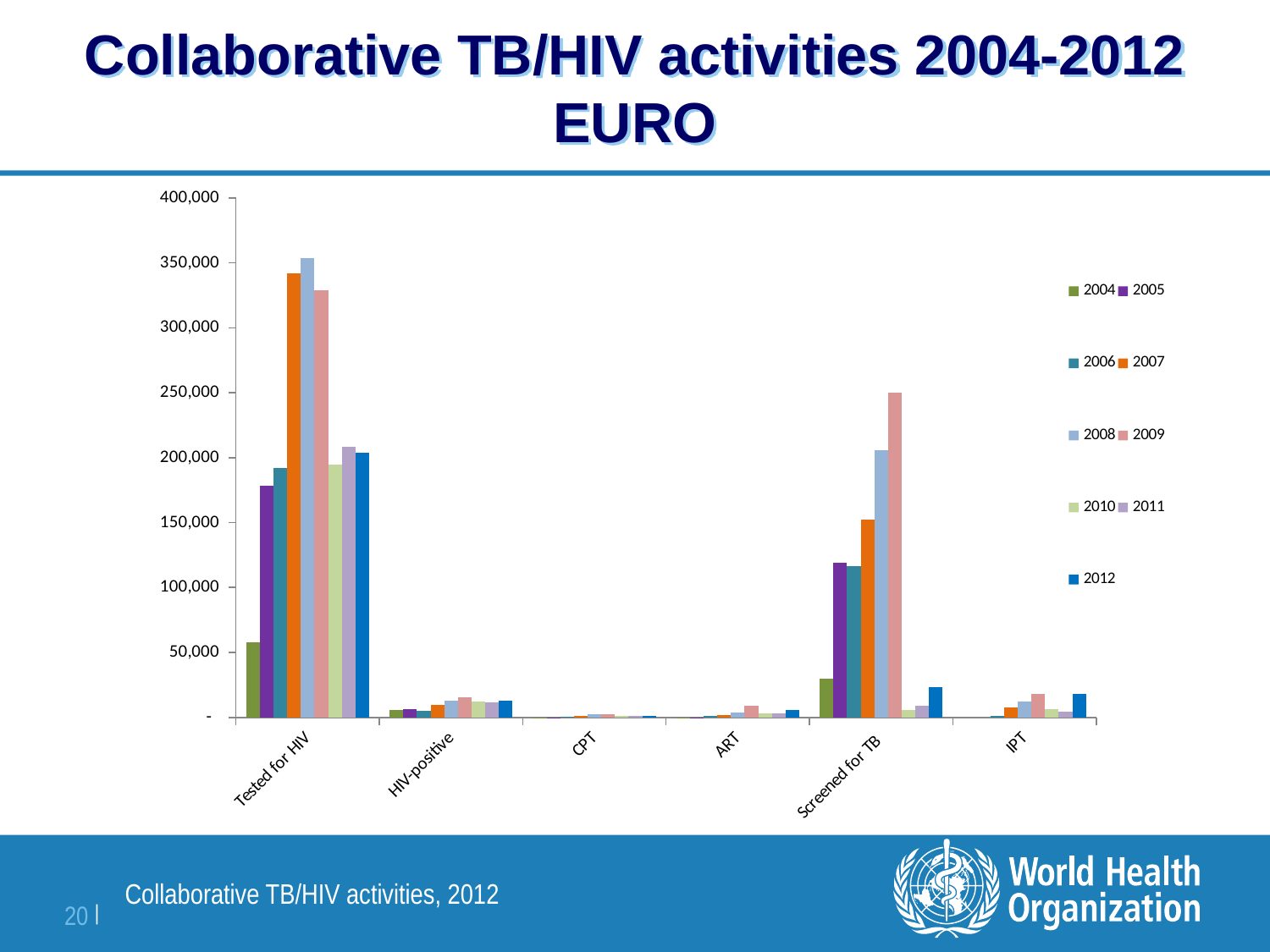
Is the 2008 value for Screened for TB greater or less than 150,000? greater Within the Tested for HIV category, which year has the lowest value? 2004 Is the 2012 value for Screened for TB greater or less than 50,000? less How many activity categories are shown on the x axis? 6 What kind of chart is shown on the slide? Bar chart How many series (years) does the legend list? 9 Is the 2008 value for Tested for HIV greater or less than 300,000? greater Which category has the tallest bar on the chart? Tested for HIV Within the Screened for TB category, which year has the highest value? 2009 Do the Screened for TB values rise or fall from 2004 to 2009? Rise For 2012, which is larger: Tested for HIV or Screened for TB? Tested for HIV